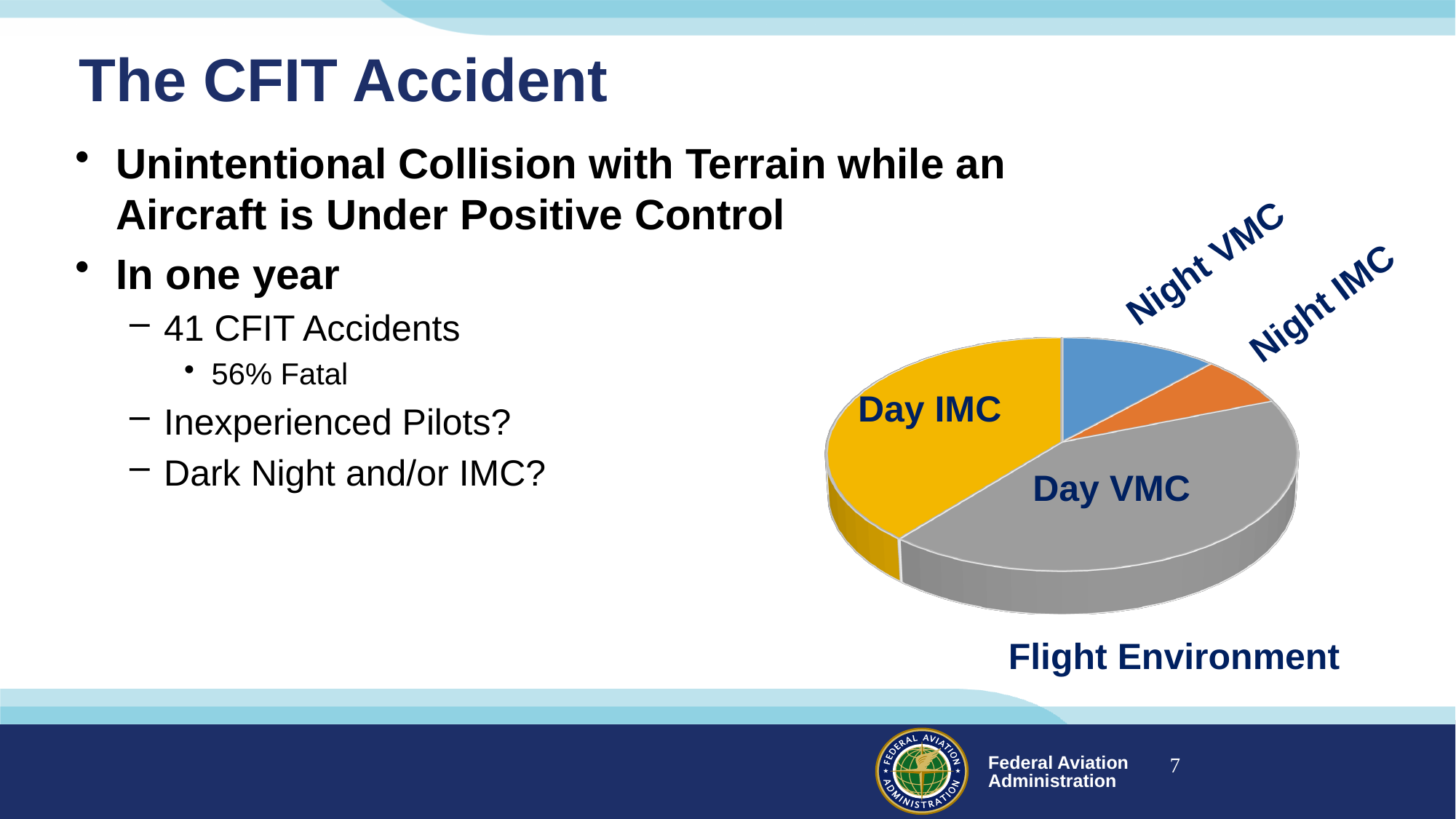
Which slice is larger, Day IMC or Night VMC? Day IMC What is the title of the pie chart? Flight Environment Which slice is larger, Night VMC or Night IMC? Night VMC How many slices does the pie chart have? 4 Which flight environment has the largest slice of the pie chart? Day VMC Which slice is larger, Day VMC or Day IMC? Day VMC What colour is the Day IMC slice of the pie chart? yellow What kind of chart is shown on the slide? pie chart Which flight environment has the smallest slice of the pie chart? Night IMC